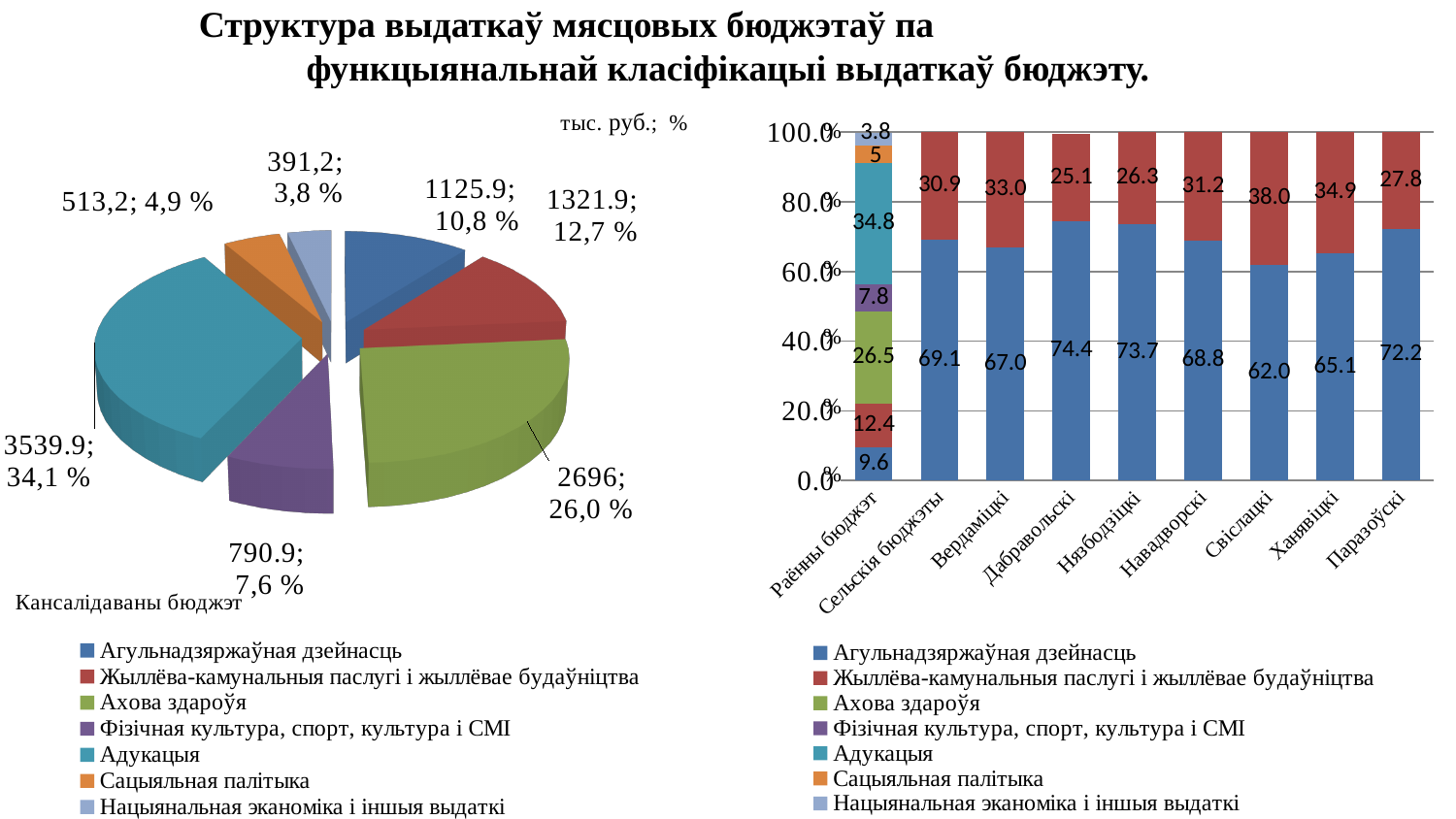
In the stacked bar chart on the right, which is larger: the red segment for Свіслацкі or the red segment for Паразоўскі? Свіслацкі In the stacked bar chart on the right, how many categories are shown on the x axis? 9 In the stacked bar chart on the right, what is the value of the red segment for Дабравольскі? 25.1 In the pie chart on the left, what value is shown for Ахова здароўя? 2696; 26,0 % In the stacked bar chart on the right, which category has the highest value for the blue series (Агульнадзяржаўная дзейнасць)? Дабравольскі In the pie chart on the left, which category has the largest share? Адукацыя In the pie chart on the left, how many slices are there? 7 How many series does the legend of the stacked bar chart on the right list? 7 In the stacked bar chart on the right, what is the value of the blue segment for Свіслацкі? 62.0 In the pie chart on the left, which category has the smallest share? Нацыянальная эканоміка і іншыя выдаткі In the pie chart on the left, what share does Адукацыя have? 34,1 % In the stacked bar chart on the right, what is the difference between the blue segment values for Паразоўскі and Ханявіцкі? 7.1